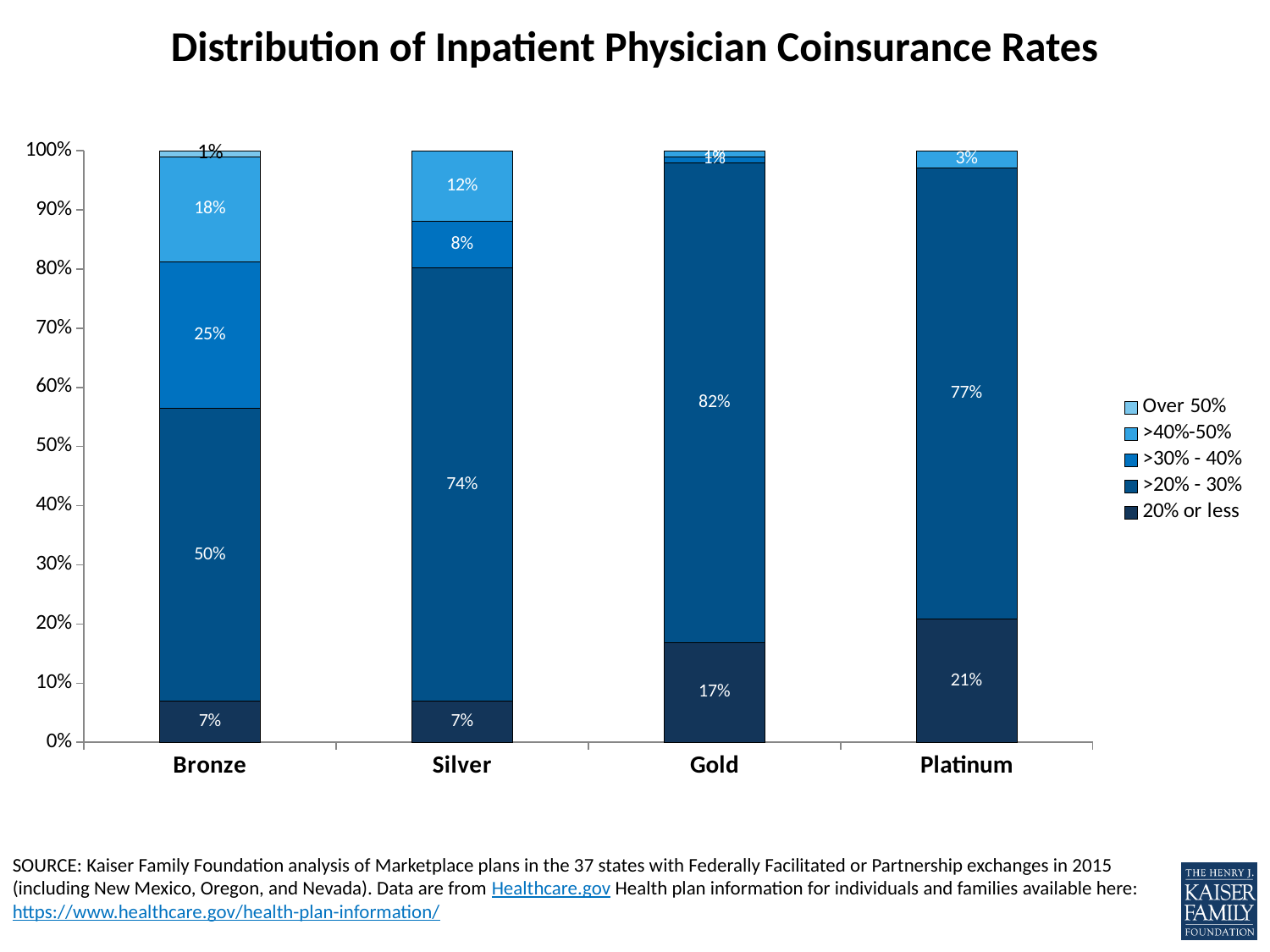
What share of Bronze plans fall in the >40%-50% coinsurance category? 18% What share of Silver plans fall in the >20% - 30% coinsurance category? 74% Which plan category has the largest share of plans with coinsurance of 20% or less? Platinum How many plan categories are shown on the x axis? 4 Which has a larger share in the >30% - 40% coinsurance range, Bronze or Silver? Bronze What kind of chart is shown on the slide? Stacked bar chart Which plan category has the largest share in the >20% - 30% coinsurance range? Gold What share of Gold plans have a coinsurance rate of 20% or less? 17% What share of Platinum plans have a coinsurance rate of 20% or less? 21% What is the difference in percentage points between the >20% - 30% share for Gold and for Platinum? 5 percentage points What share of Bronze plans have an inpatient physician coinsurance rate of >20% - 30%? 50% How many series does the legend list? 5